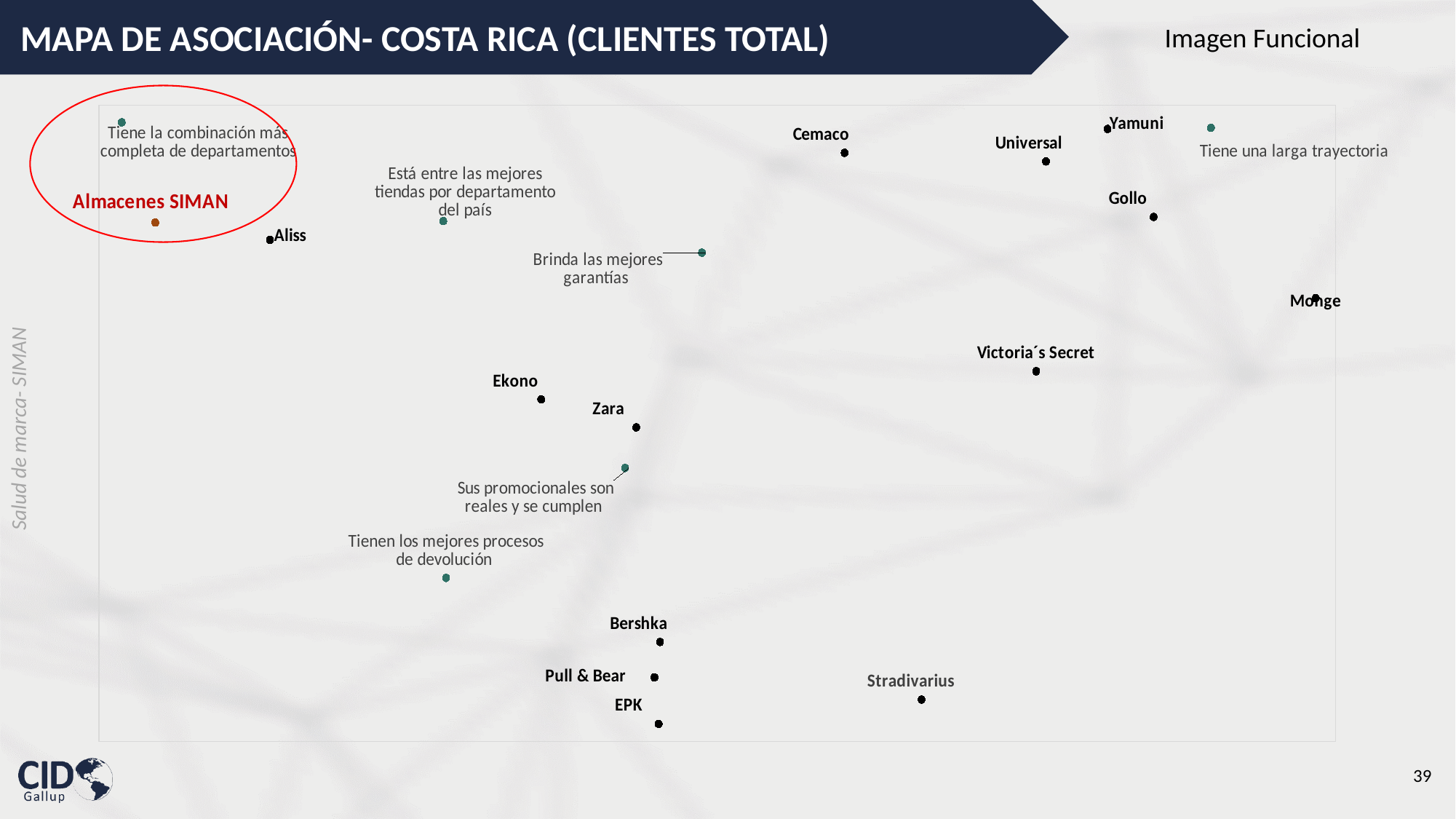
Which brand is plotted closest to the attribute 'Sus promocionales son reales y se cumplen'? Zara Which brand is plotted furthest to the right on the association map? Monge What kind of chart is shown on the slide? Scatter plot (association map) What is the title of the slide containing the association map? MAPA DE ASOCIACIÓN- COSTA RICA (CLIENTES TOTAL) How many brands are plotted on the association map? 14 Which brand is plotted closer to Bershka: Pull & Bear or Stradivarius? Pull & Bear Which attribute is plotted closest to Almacenes SIMAN? Tiene la combinación más completa de departamentos How many attribute statements are plotted on the association map? 6 Which brand is circled in red on the association map? Almacenes SIMAN Which brand is plotted lowest on the association map? EPK Which brand is plotted closest to the attribute 'Está entre las mejores tiendas por departamento del país'? Aliss